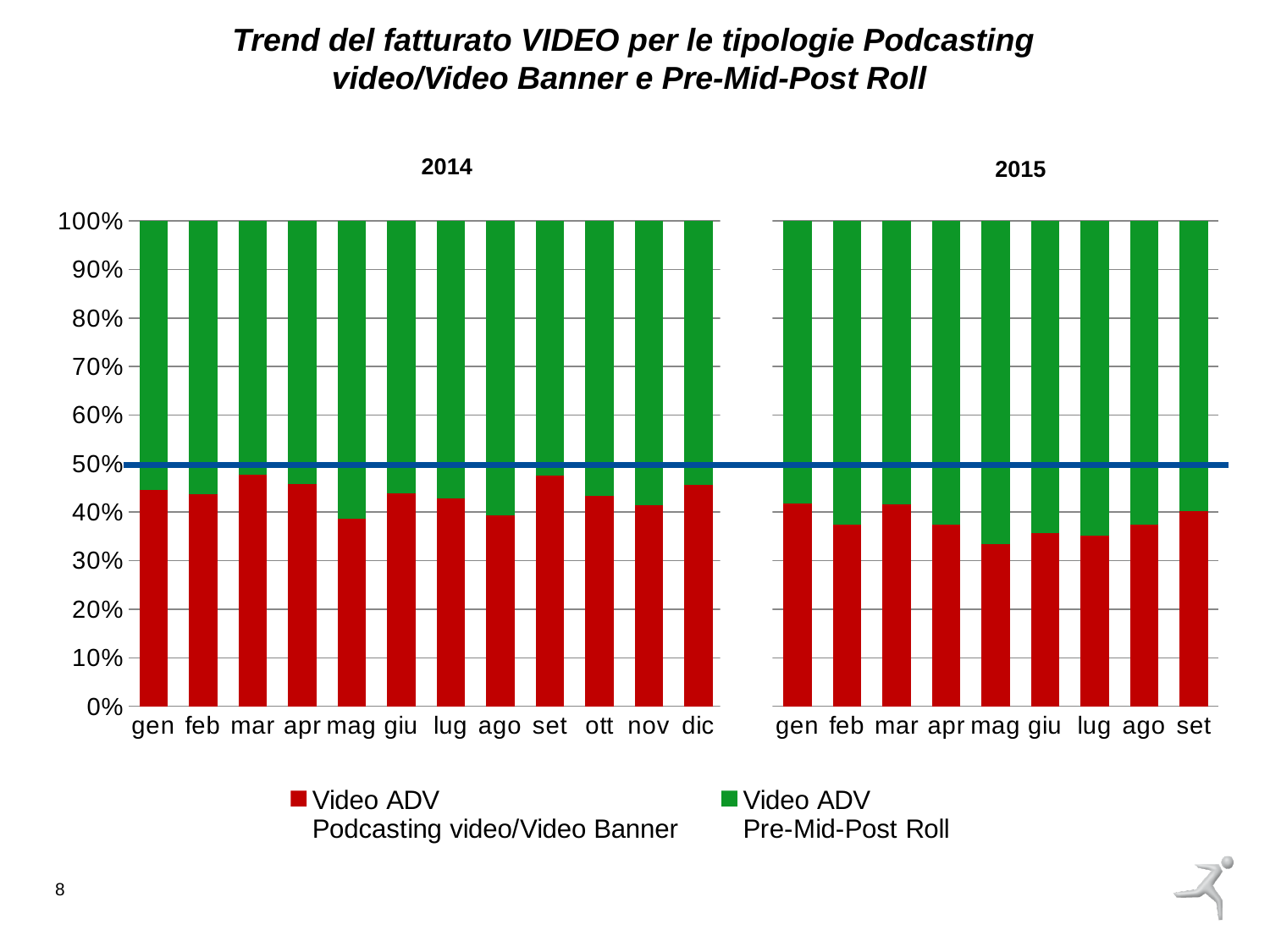
What kind of chart is shown on the slide? Stacked bar chart At what level is the horizontal blue reference line drawn? 50% How many series does the legend list? 2 How many months are plotted for 2014? 12 Is the Video ADV Podcasting video/Video Banner share for mag 2015 greater or less than 40%? less Is the Video ADV Podcasting video/Video Banner share for gen 2014 greater or less than 40%? greater What does each stacked bar total? 100% How many months are plotted for 2015? 9 Is the Video ADV Pre-Mid-Post Roll share for mag 2015 greater or less than 60%? greater Which is larger, the Video ADV Podcasting video/Video Banner share for mar 2014 or for mag 2014? mar 2014 Which is larger, the Video ADV Pre-Mid-Post Roll share for gen 2014 or for mag 2015? mag 2015 Which month has the lowest Video ADV Podcasting video/Video Banner share across both years? mag 2015